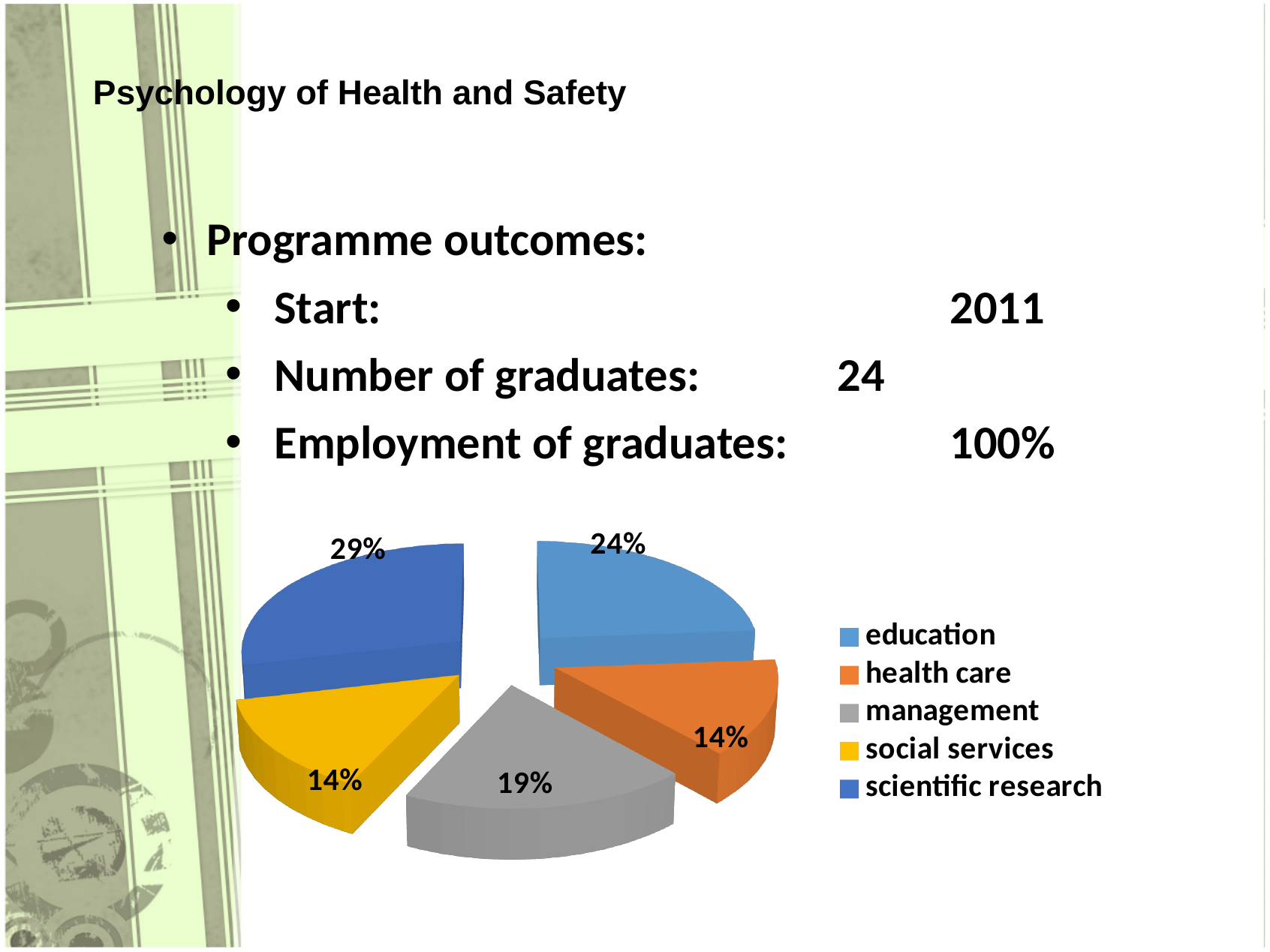
Which colour represents social services in the pie chart? yellow What is the difference between the share for scientific research and the share for social services? 15% How many entries does the legend list? 5 What share of the pie does management account for? 19% How many slices does the pie chart have? 5 What share of the pie does scientific research account for? 29% Which is larger, the share for education or the share for management? education Which category has the largest slice of the pie? scientific research What is the difference between the share for education and the share for management? 5% What share of the pie does education account for? 24% What kind of chart is shown on the slide? pie chart